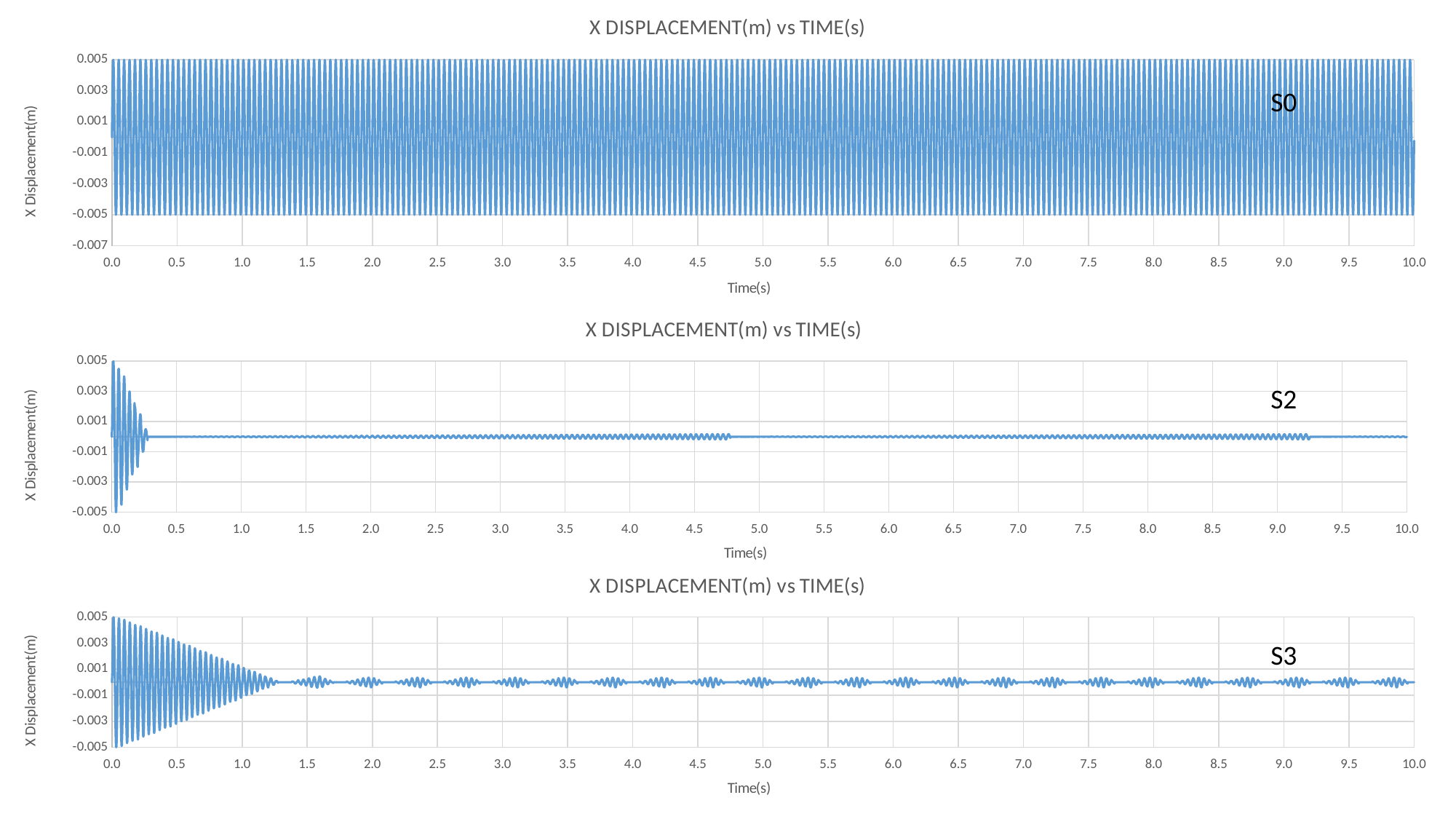
How many charts are shown on the slide? 3 What is the x-axis label on the bottom chart labelled S3? Time(s) What is the maximum value shown on the x axis of the top chart labelled S0? 10.0 In the bottom chart labelled S3, is the displacement at time 8.0 greater or less than 0.003? less In the middle chart labelled S2, does the amplitude of the oscillation rise or fall over the first 0.5 seconds? fall In the top chart labelled S0, does the amplitude of the oscillation rise, fall, or stay roughly constant from 0.0 to 10.0 seconds? stay roughly constant What kind of chart is the top chart labelled S0? line chart Which chart keeps a large oscillation amplitude for the full 10 seconds: the one labelled S0, S2, or S3? S0 Which chart's oscillation decays to near zero sooner: the one labelled S2 or the one labelled S3? S2 In the middle chart labelled S2, is the displacement at time 5.0 greater or less than 0.003? less What is the title of the middle chart labelled S2? X DISPLACEMENT(m) vs TIME(s) In the bottom chart labelled S3, does the amplitude of the oscillation rise or fall between 0.0 and 1.0 seconds? fall